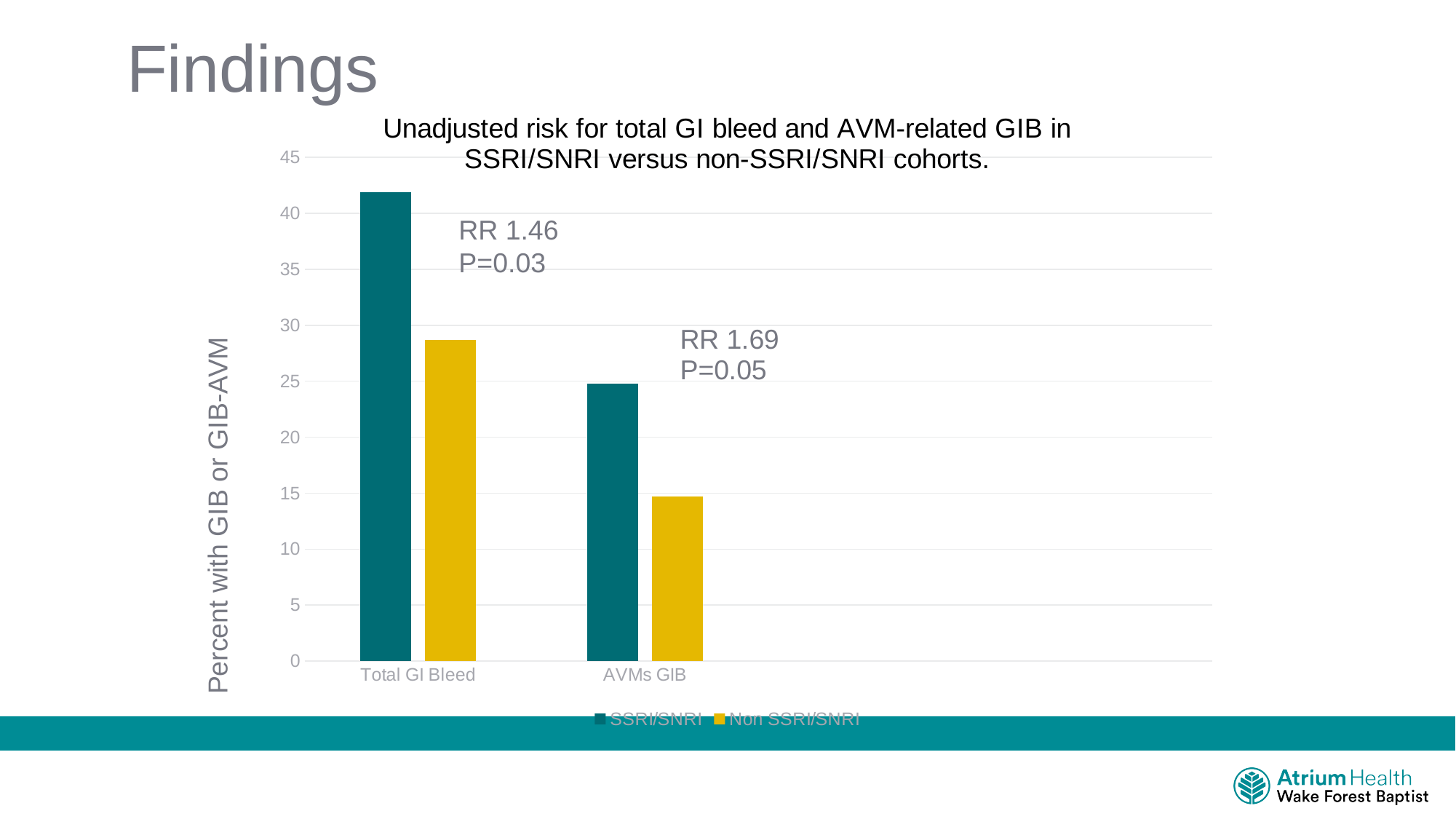
How many series does the legend list? 2 How many categories are shown on the x axis? 2 Is the SSRI/SNRI value for Total GI Bleed greater or less than 40? greater Is the Non SSRI/SNRI value for Total GI Bleed greater or less than 30? less What kind of chart is shown on the slide? bar chart What relative risk (RR) is annotated next to the Total GI Bleed bars? RR 1.46 Which category has the highest SSRI/SNRI bar? Total GI Bleed For AVMs GIB, which series has the larger value, SSRI/SNRI or Non SSRI/SNRI? SSRI/SNRI Which category has the lowest Non SSRI/SNRI bar? AVMs GIB Is the SSRI/SNRI value for AVMs GIB greater or less than 20? greater For Total GI Bleed, which series has the larger value, SSRI/SNRI or Non SSRI/SNRI? SSRI/SNRI